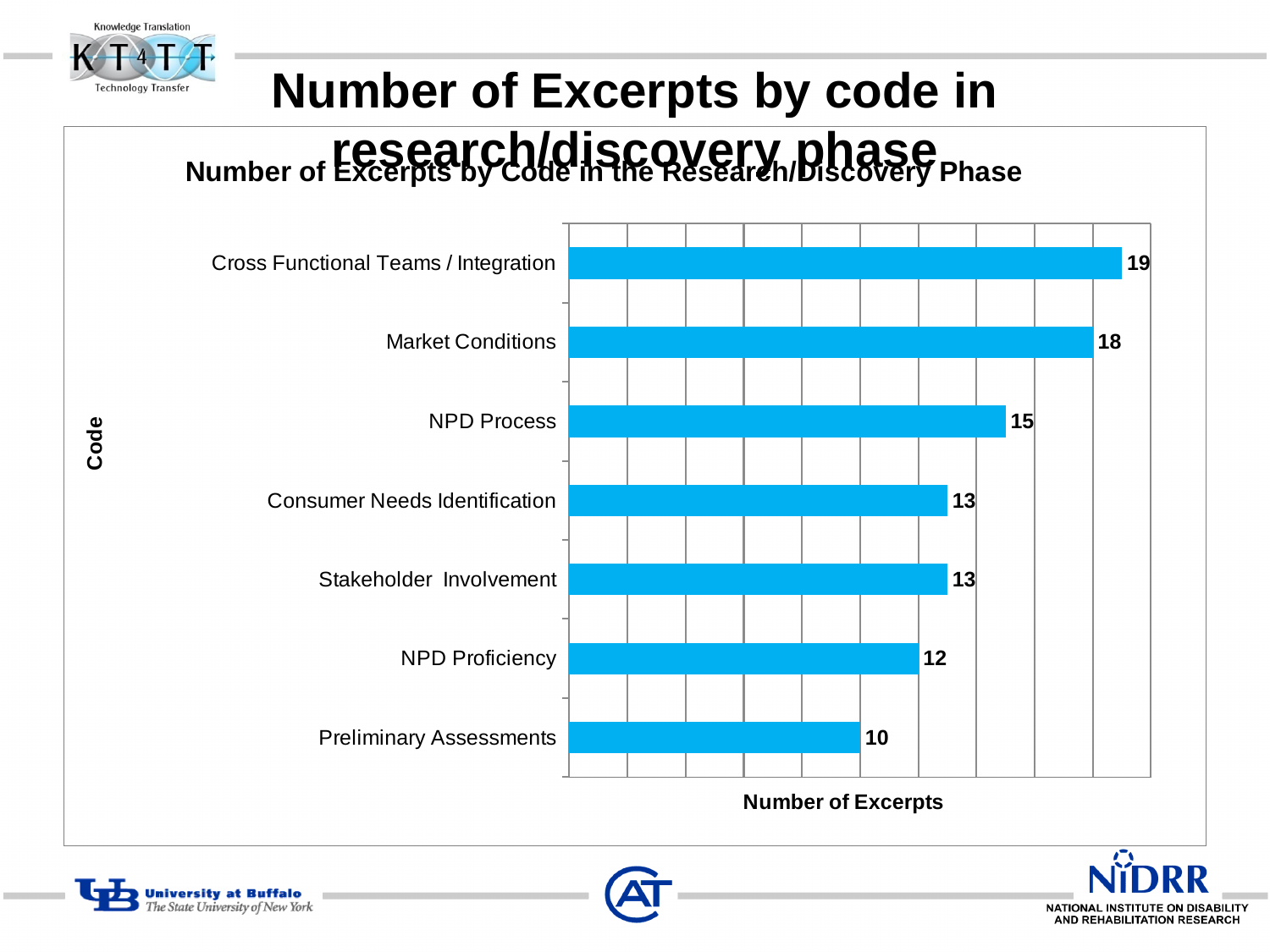
What is the label of the horizontal axis of the chart? Number of Excerpts What is the label of the vertical axis of the chart? Code What kind of chart is shown on the slide? Bar chart Which has more excerpts, Market Conditions or Consumer Needs Identification? Market Conditions What is the difference in number of excerpts between NPD Process and Stakeholder Involvement? 2 What is the number of excerpts for Market Conditions? 18 What is the number of excerpts for NPD Process? 15 Which code has the lowest number of excerpts? Preliminary Assessments Which code has the highest number of excerpts? Cross Functional Teams / Integration How many codes are shown in the chart? 7 What is the number of excerpts for Preliminary Assessments? 10 What is the difference in number of excerpts between Cross Functional Teams / Integration and NPD Proficiency? 7